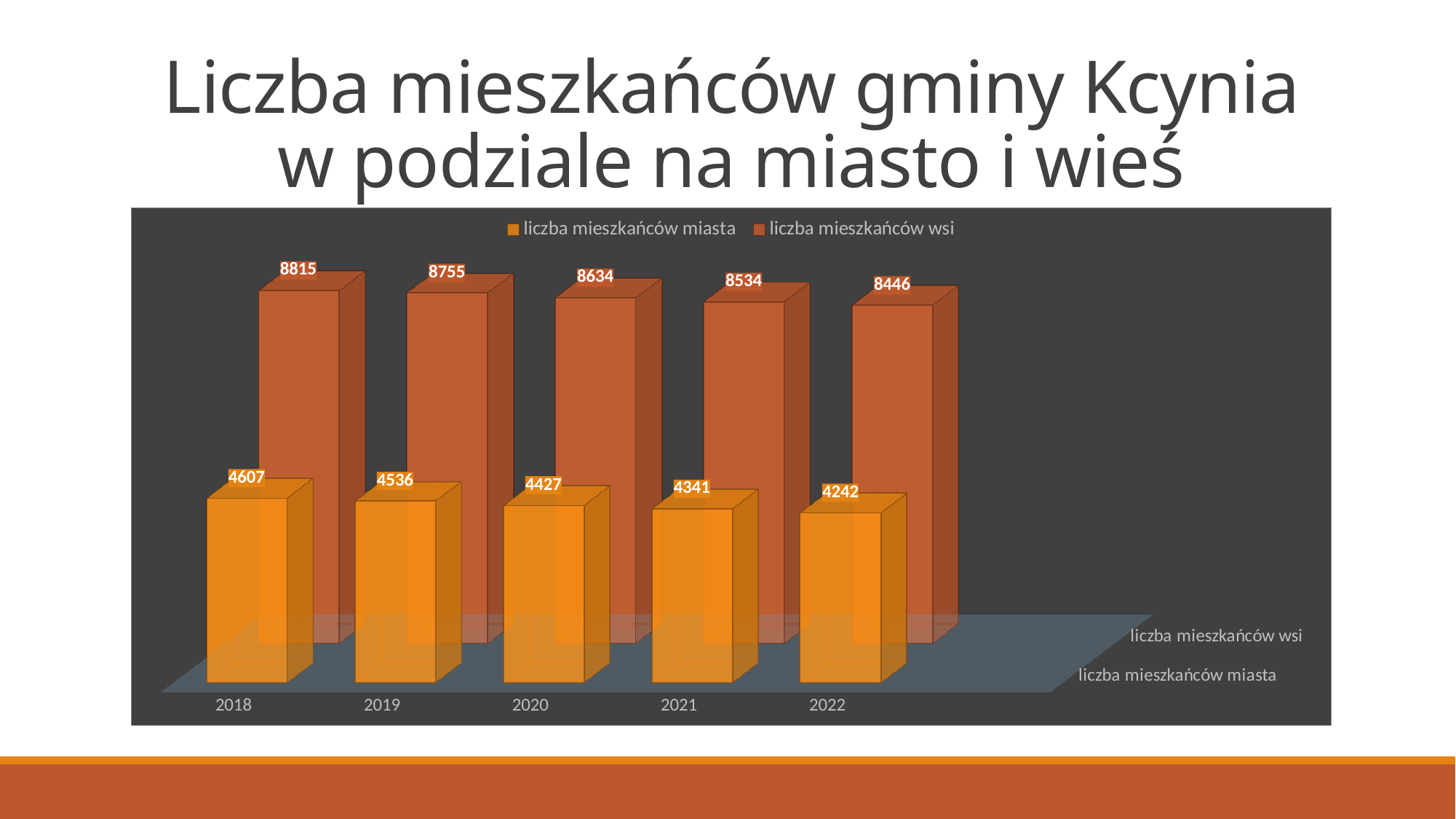
What is the value of liczba mieszkańców miasta for 2018? 4607 In which year is liczba mieszkańców miasta lowest? 2022 In which year is liczba mieszkańców wsi highest? 2018 What is the value of liczba mieszkańców wsi for 2022? 8446 By how much did liczba mieszkańców miasta change from 2018 to 2022? 365 How many years are shown on the x axis? 5 Does liczba mieszkańców wsi rise or fall from 2018 to 2022? fall What is the value of liczba mieszkańców miasta for 2021? 4341 How many series does the legend list? 2 Which is larger in 2020: liczba mieszkańców miasta or liczba mieszkańców wsi? liczba mieszkańców wsi What is the value of liczba mieszkańców wsi for 2020? 8634 What is the difference between liczba mieszkańców wsi and liczba mieszkańców miasta in 2019? 4219